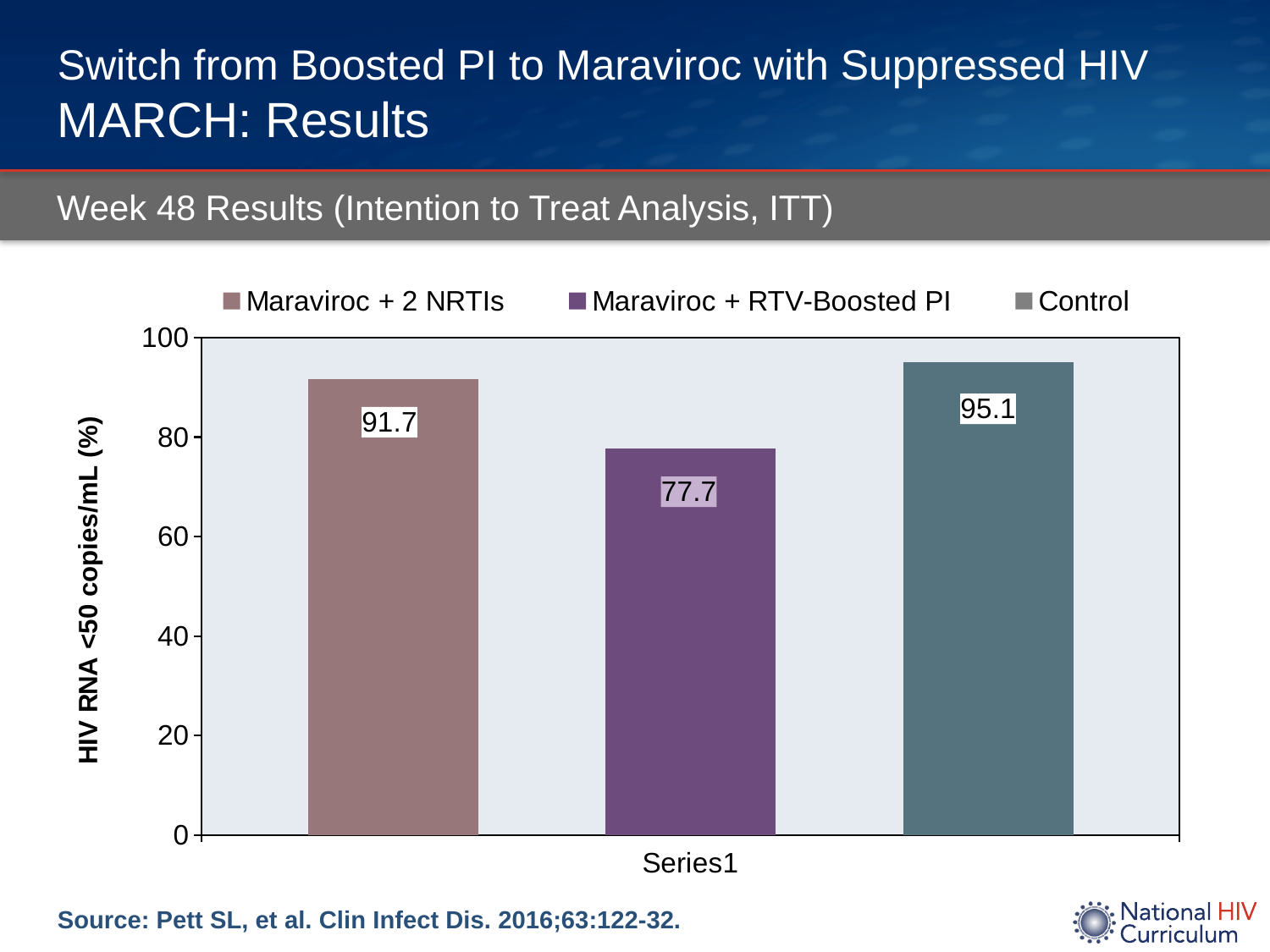
What is the value for Control? 95.1 What is the value for Maraviroc + RTV-Boosted PI? 77.7 What kind of chart is shown on the slide? bar chart Which series has the highest value? Control Which is larger, the value for Maraviroc + 2 NRTIs or the value for Maraviroc + RTV-Boosted PI? Maraviroc + 2 NRTIs What is the difference between the Control value and the Maraviroc + RTV-Boosted PI value? 17.4 What is the value for Maraviroc + 2 NRTIs? 91.7 How many series does the legend list? 3 What is the label of the y axis? HIV RNA <50 copies/mL (%) Which series has the lowest value? Maraviroc + RTV-Boosted PI Is the value for Maraviroc + RTV-Boosted PI greater or less than 80? less What is the difference between the Control value and the Maraviroc + 2 NRTIs value? 3.4